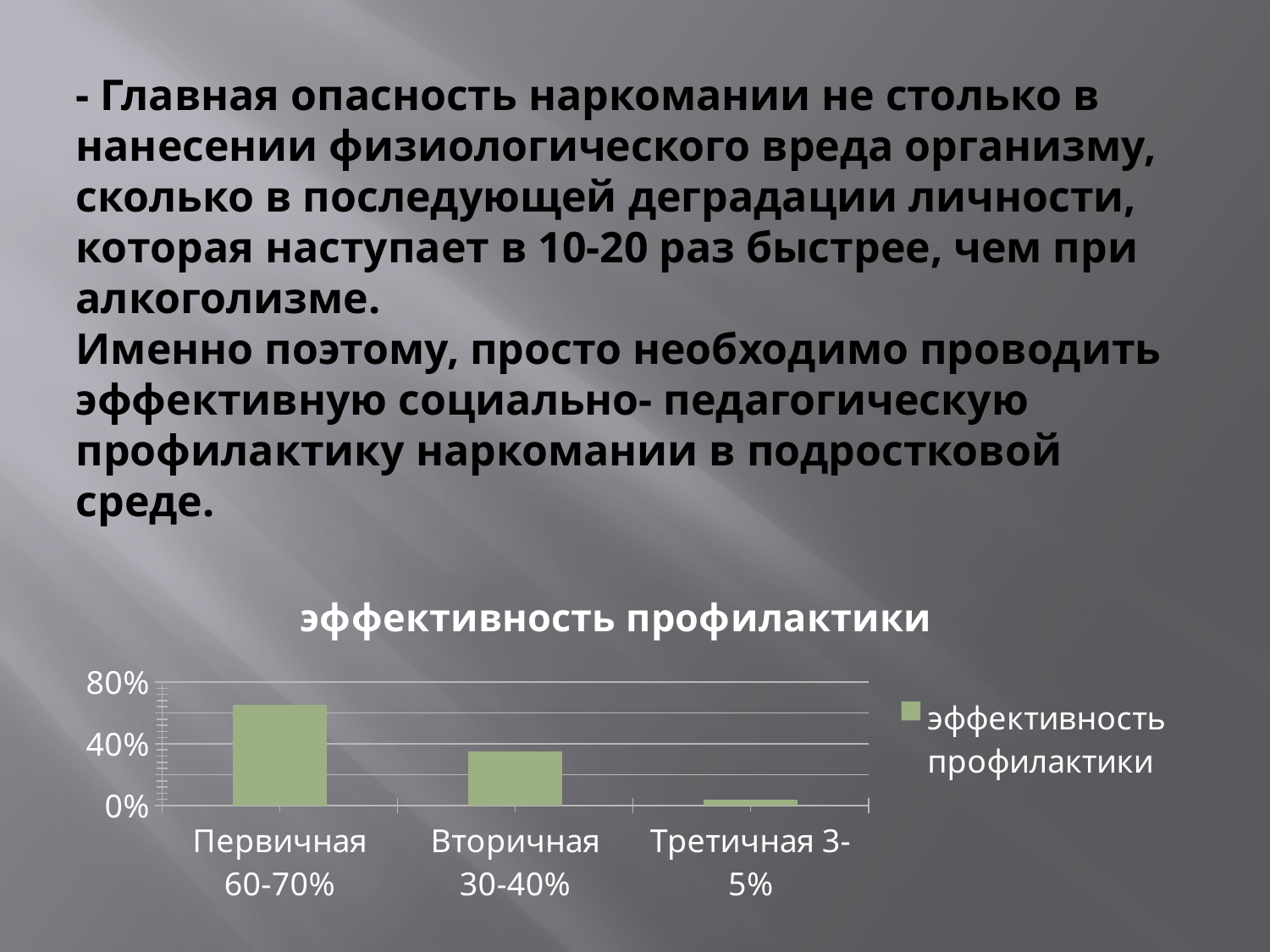
Which bar is taller: Вторичная 30-40% or Третичная 3-5%? Вторичная 30-40% What is the title of the chart? эффективность профилактики Is the value for Вторичная 30-40% greater or less than 40%? less Which category has the highest bar in the chart? Первичная 60-70% Which bar is taller: Первичная 60-70% or Вторичная 30-40%? Первичная 60-70% Is the value for Первичная 60-70% greater or less than 40%? greater Which category has the lowest bar in the chart? Третичная 3-5% How many categories are shown on the x axis of the chart? 3 What is the name of the series listed in the chart legend? эффективность профилактики Do the bar values rise or fall from left to right along the x axis? fall How many series does the chart legend list? 1 What kind of chart is shown on the slide? bar chart